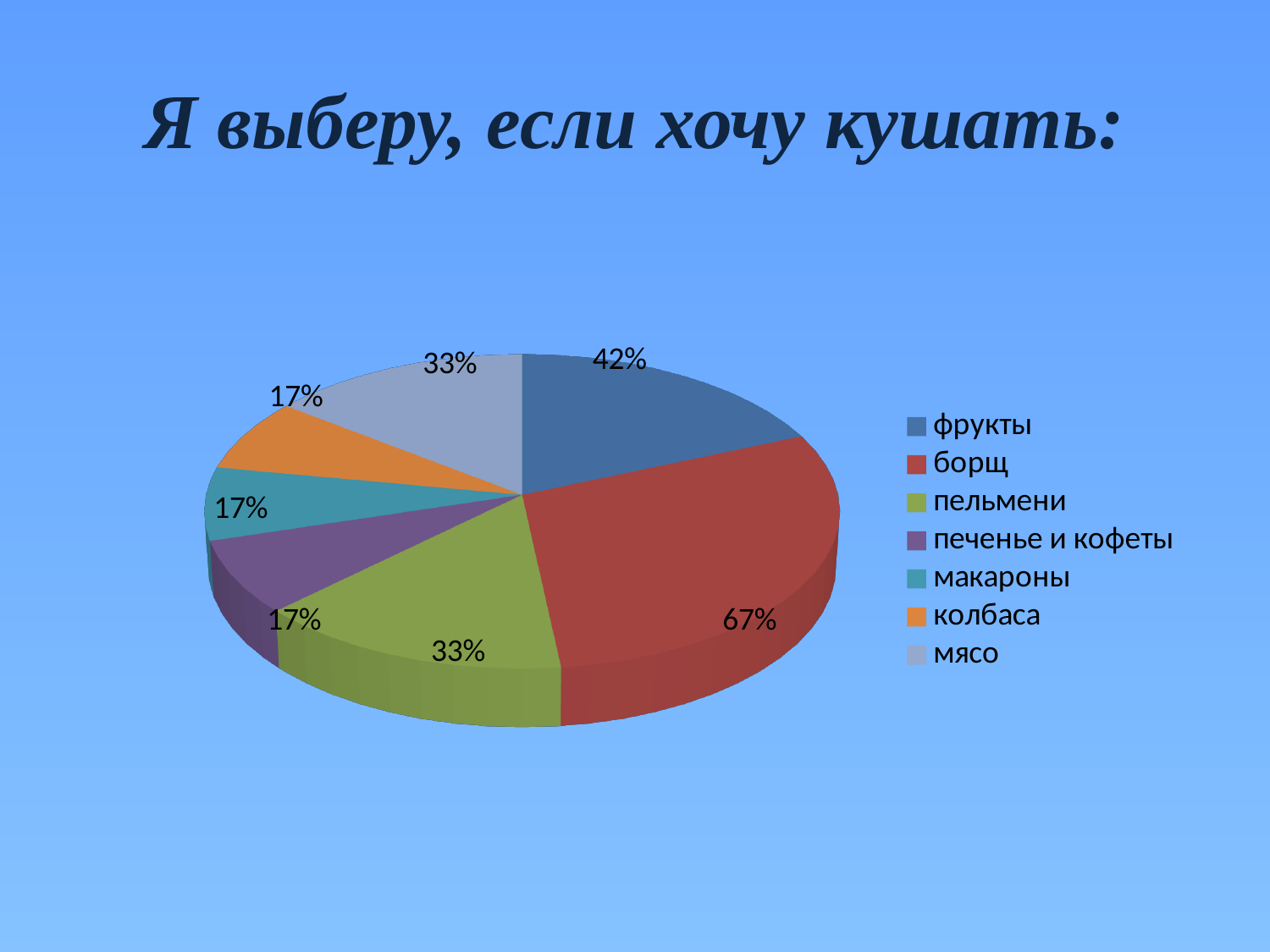
What value is shown for борщ? 67% What value is shown for мясо? 33% What value is shown for фрукты? 42% What kind of chart is shown on the slide? Pie chart What is the title of the chart? Я выберу, если хочу кушать: What value is shown for колбаса? 17% What is the difference between the values for борщ and фрукты? 25 percentage points Which category has the largest slice? борщ How many categories does the legend list? 7 Which colour represents макароны in the legend? Teal Which is larger, the value for борщ or the value for фрукты? борщ What value is shown for пельмени? 33%